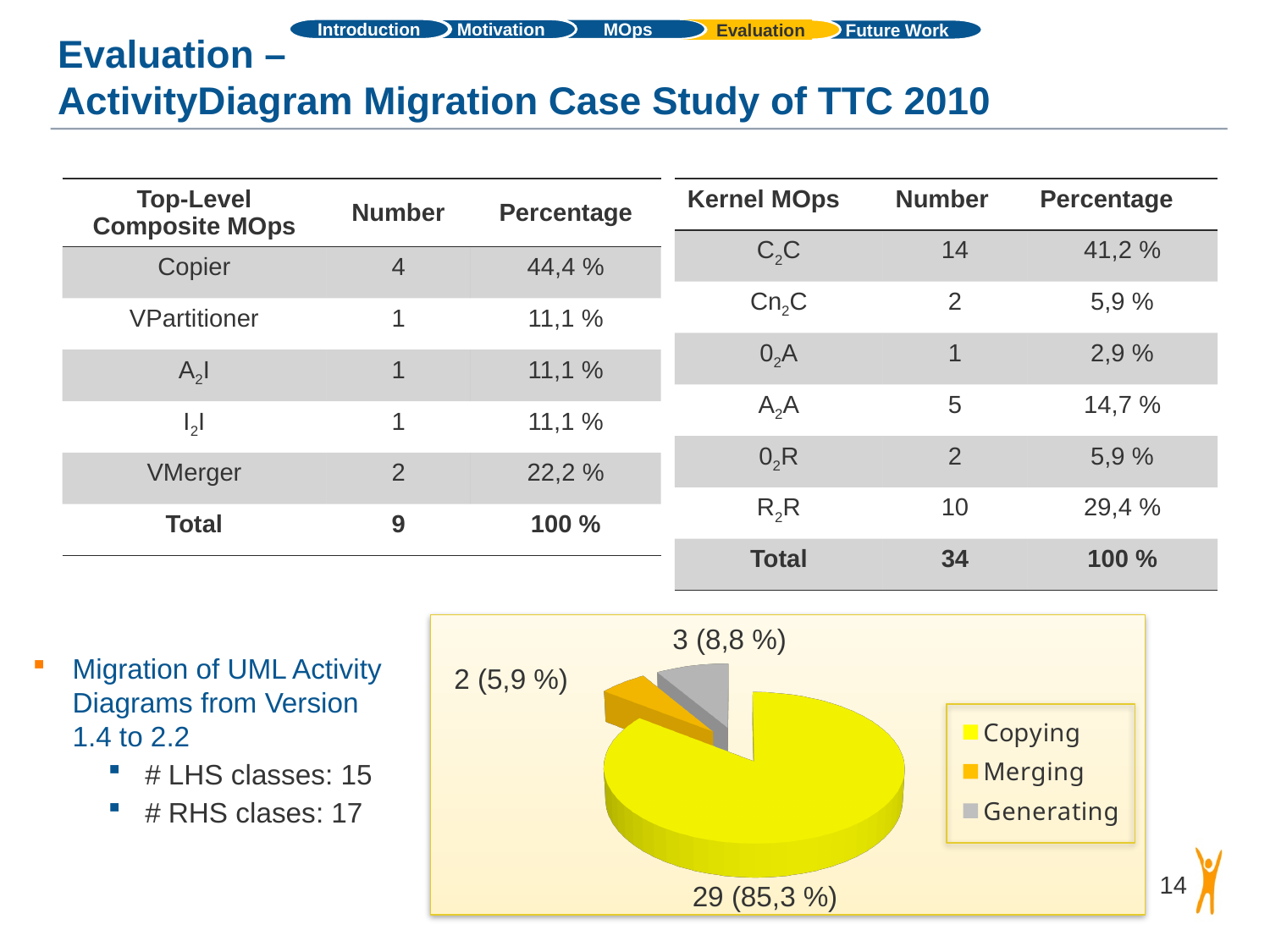
In the pie chart, what is the value shown for Copying? 29 (85,3 %) In the pie chart, what is the value shown for Generating? 3 (8,8 %) In the pie chart, which category has the smallest slice? Merging In the pie chart, what share of the pie does Copying take? 85,3 % In the pie chart, which colour represents Merging in the legend? orange In the pie chart, what is the difference in count between Copying and Generating? 26 What kind of chart is shown at the bottom of the slide? pie chart How many entries does the pie chart's legend list? 3 In the pie chart, what is the value shown for Merging? 2 (5,9 %) In the pie chart, which is larger, the Generating slice or the Merging slice? Generating In the pie chart, how many slices are there? 3 In the pie chart, which category has the largest slice? Copying